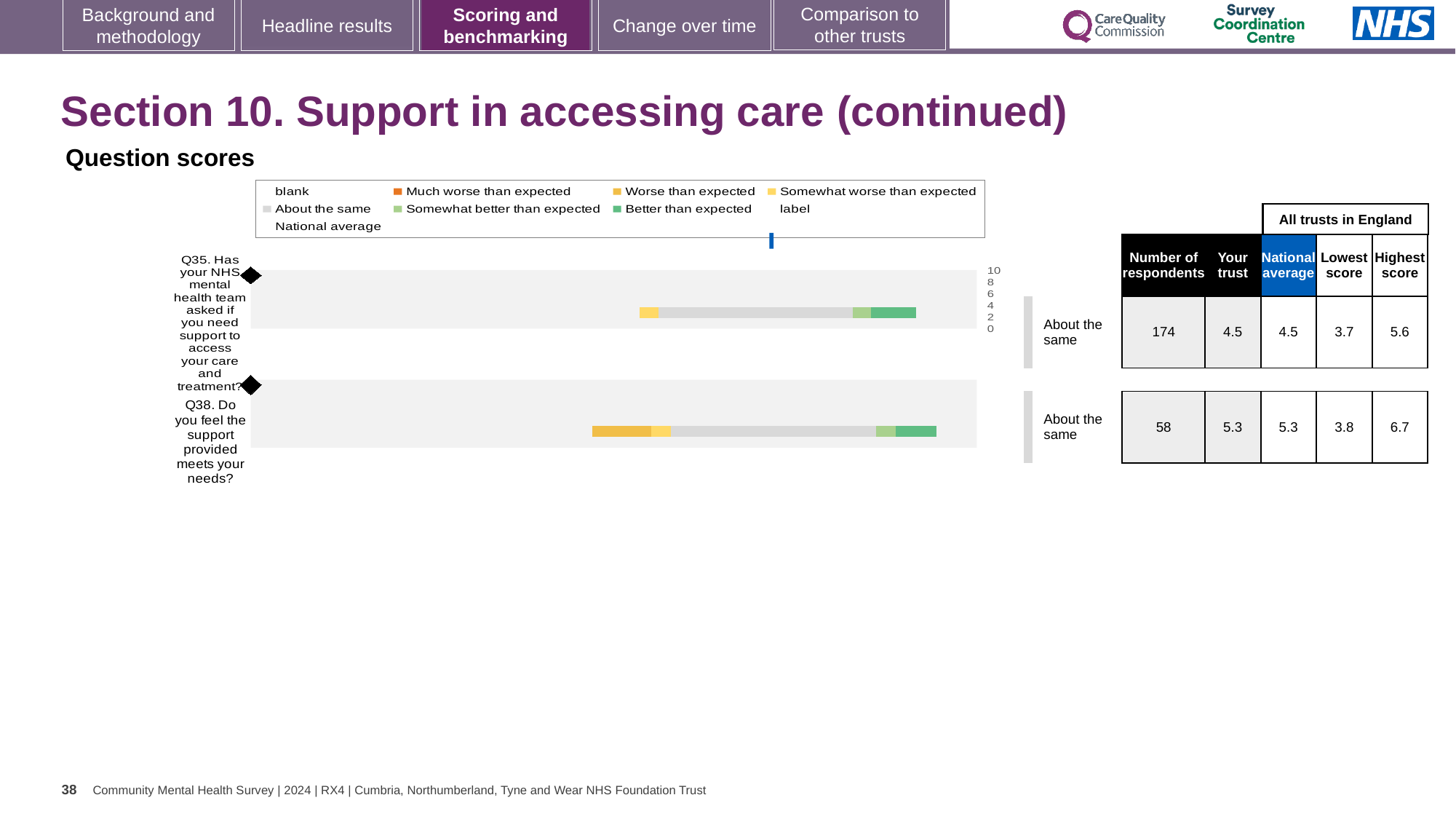
How many respondents answered Q38? 58 Which question had more respondents, Q35 or Q38? Q35 How many survey questions are plotted in the 'Question scores' chart? 2 What is the 'Your trust' score for Q35 (Has your NHS mental health team asked if you need support to access your care and treatment?)? 4.5 What is the 'Your trust' score for Q38 (Do you feel the support provided meets your needs?)? 5.3 What benchmark category is shown next to the bar for Q35? About the same What is the lowest score across all trusts in England for Q35? 3.7 How many respondents answered Q35? 174 What kind of chart is shown under 'Question scores'? Bar chart What is the highest score across all trusts in England for Q38? 6.7 How many more respondents answered Q35 than Q38? 116 What is the difference between the highest and lowest scores for Q38? 2.9